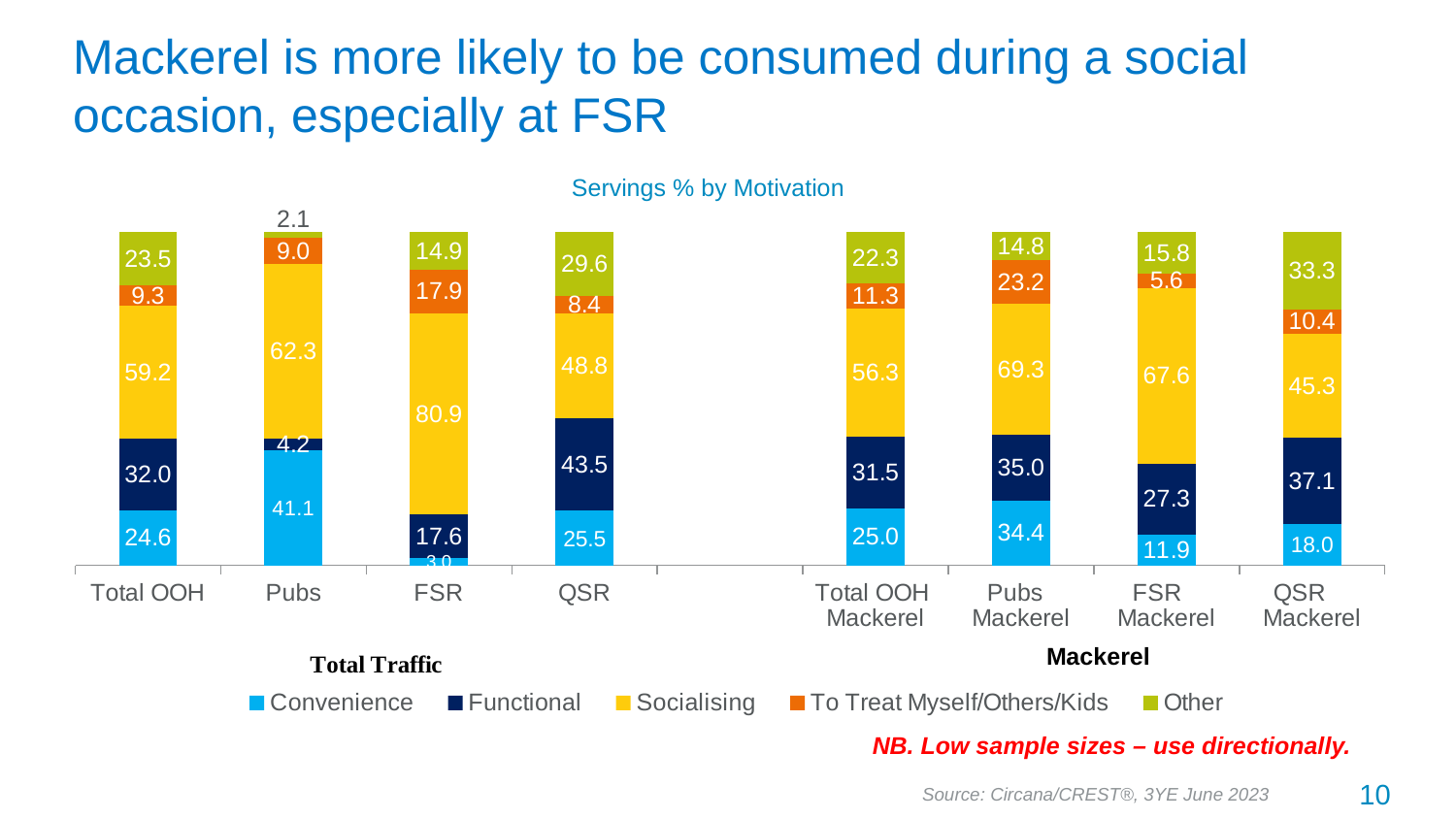
What is the Socialising value for FSR? 80.9 Which category has the lowest Other value? Pubs What kind of chart is shown on the slide? Stacked bar chart How many series does the legend list? 5 What is the Functional value for Total OOH? 32.0 How many categories are shown on the x axis? 8 What is the Other value for QSR Mackerel? 33.3 What is the difference between the Convenience values for Pubs Mackerel and FSR Mackerel? 22.5 What is the Convenience value for Pubs? 41.1 Which category has the highest Socialising value? FSR Which is larger, the Socialising value for Pubs Mackerel or for FSR Mackerel? Pubs Mackerel What is the To Treat Myself/Others/Kids value for Pubs Mackerel? 23.2